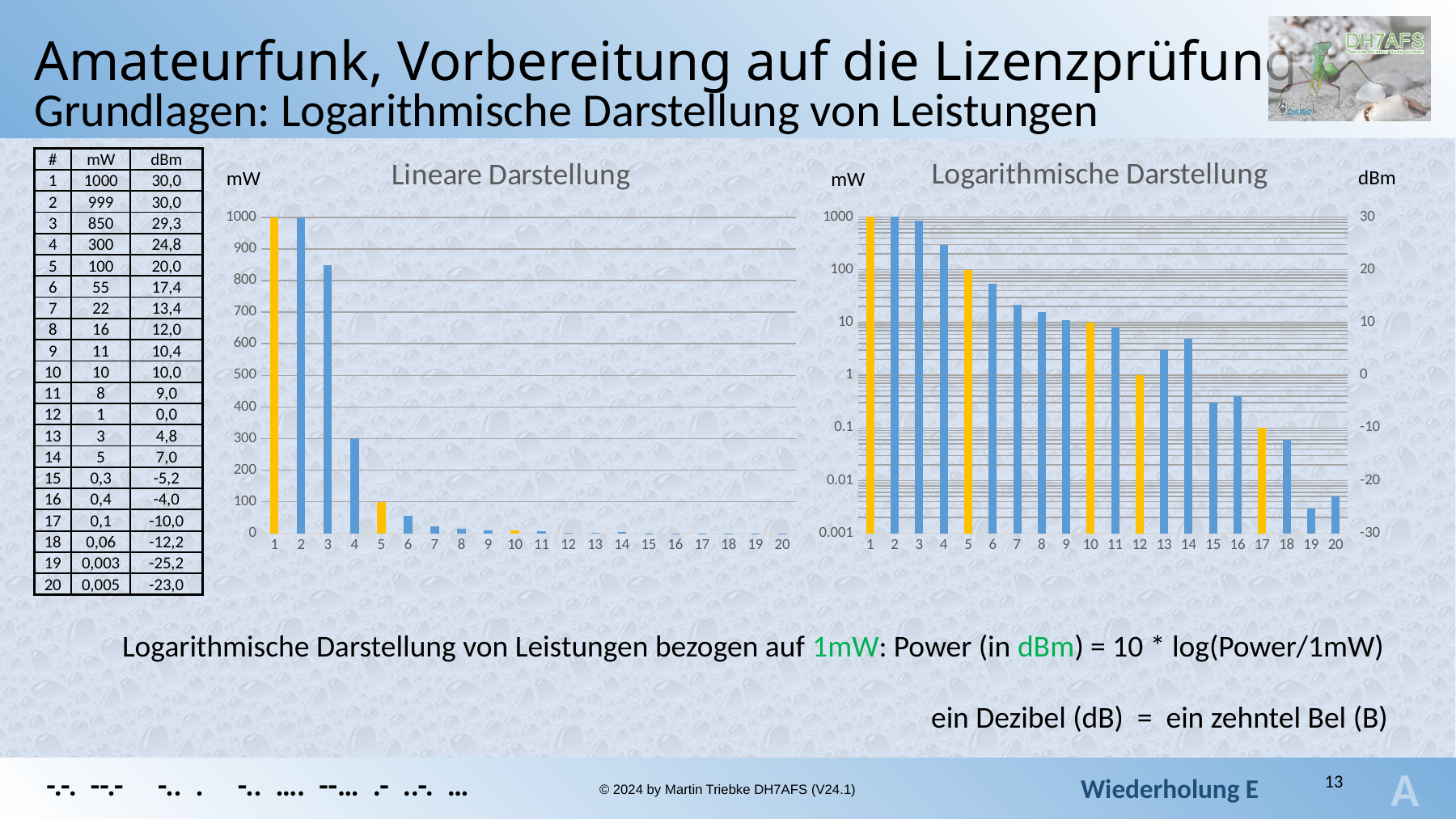
In the "Lineare Darstellung" chart, is the value for category 4 greater or less than 400? less In the "Lineare Darstellung" chart, what is the value for category 1? 1000 In the "Logarithmische Darstellung" chart, what is the value for category 12? 1 How many categories are shown on the x axis of the "Logarithmische Darstellung" chart? 20 In the "Lineare Darstellung" chart, what is the value for category 5? 100 In the "Lineare Darstellung" chart, is the value for category 3 greater or less than 800? greater In the "Lineare Darstellung" chart, do the values generally rise or fall from left to right along the x axis? fall In the "Lineare Darstellung" chart, which is larger, the value for category 4 or category 5? category 4 What is the label on the right-hand axis of the "Logarithmische Darstellung" chart? dBm In the "Logarithmische Darstellung" chart, is the value for category 19 greater or less than 0.01? less In the "Lineare Darstellung" chart, what is the difference between the values for category 1 and category 5? 900 What kind of chart is the "Lineare Darstellung" chart? bar chart